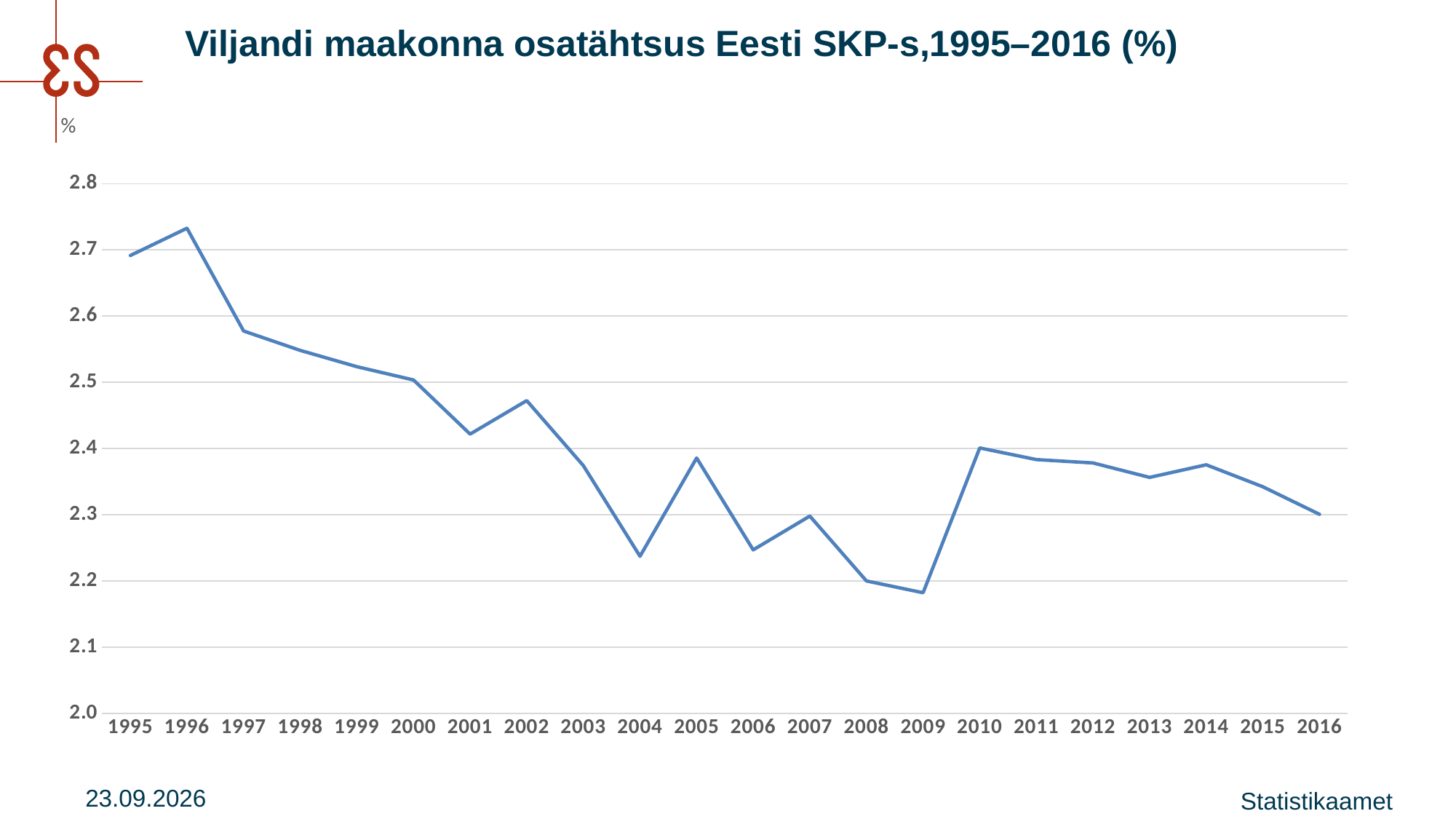
Is the value for 2004 greater or less than 2.3? less How many years are plotted on the x axis? 22 Is the value for 1996 greater or less than 2.7? greater Is the value for 1997 greater or less than 2.6? less In which year is the value lowest? 2009 Which year has the larger value, 2004 or 2005? 2005 Overall, does the value rise or fall from 1995 to 2016? fall In which year is the value highest? 1996 What kind of chart is shown on the slide? line chart Which year has the larger value, 1995 or 2016? 1995 What is the title of the chart? Viljandi maakonna osatähtsus Eesti SKP-s,1995–2016 (%)